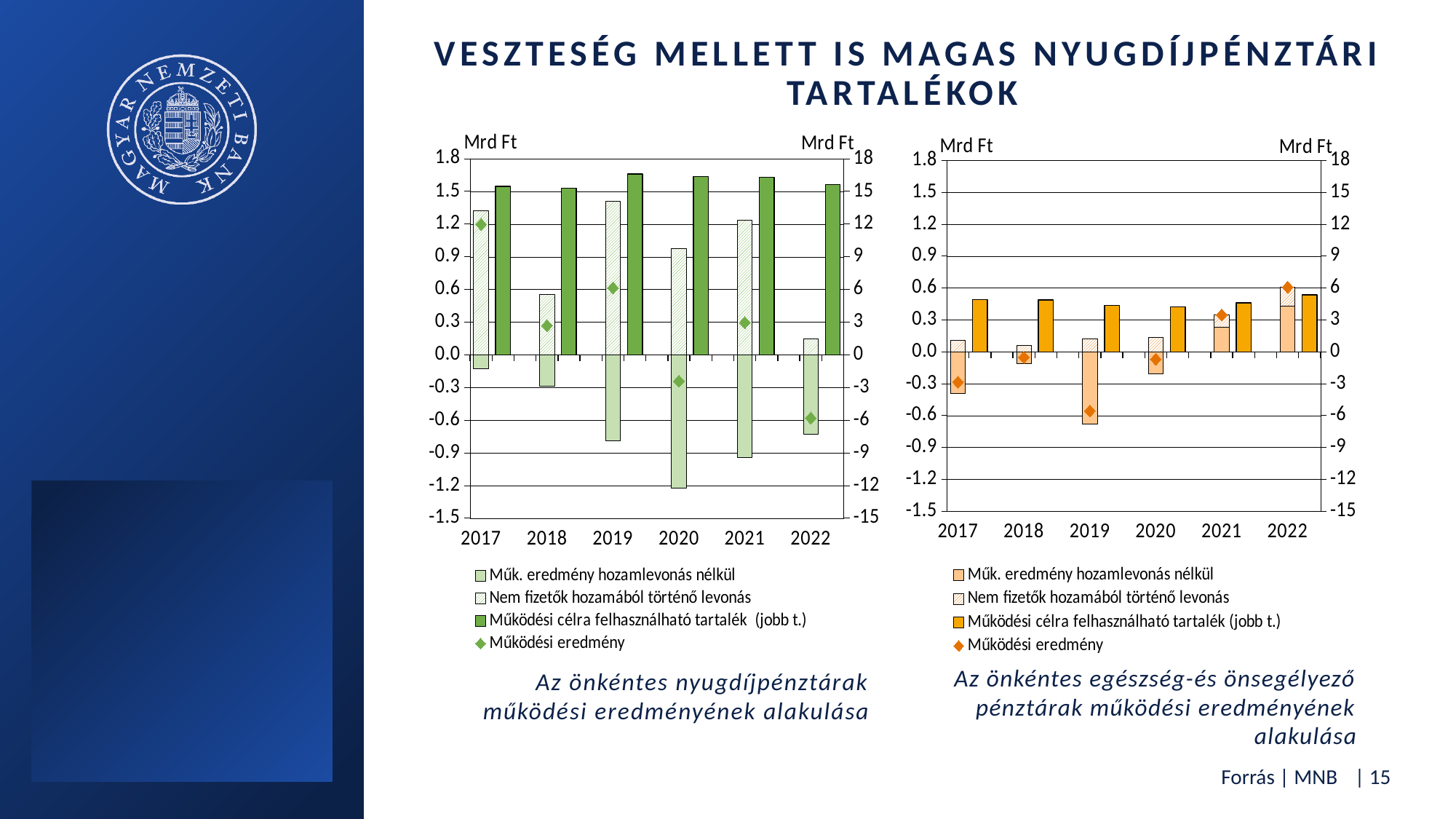
On the left chart, is the Nem fizetők hozamából történő levonás value for 2022 greater or less than 0.3? less On the right chart (Az önkéntes egészség-és önsegélyező pénztárak működési eredményének alakulása), what kind of chart is it? combination bar and line chart On the right chart, in which year is the Működési eredmény marker lowest? 2019 On the left chart, in which year is the Műk. eredmény hozamlevonás nélkül bar lowest? 2020 On the left chart, how many series does the legend list? 4 On the left chart, in which year is the Működési eredmény marker lowest? 2022 On the right chart, in which year is the Működési eredmény marker highest? 2022 On the right chart, which year has the larger Működési eredmény value, 2021 or 2022? 2022 On the left chart (Az önkéntes nyugdíjpénztárak működési eredményének alakulása), how many years are shown on the x axis? 6 On the left chart, in which year is the Működési eredmény marker highest? 2017